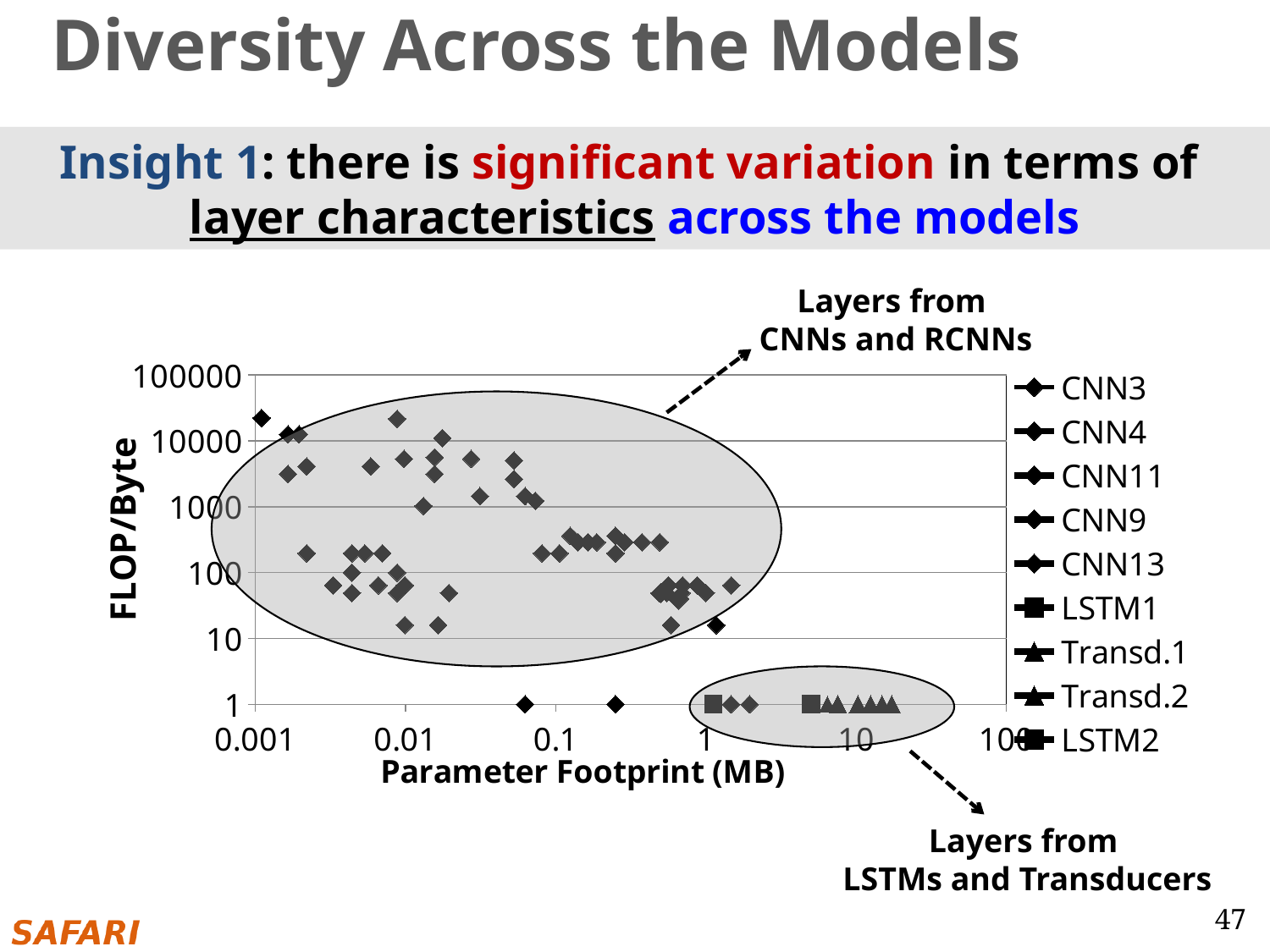
Is the parameter footprint of the layers from LSTMs and Transducers greater or less than 0.1 MB? greater What kind of chart is shown on the slide? Scatter plot What is the label of the y-axis of the chart? FLOP/Byte According to the annotation, which models do the layers in the large upper ellipse come from? CNNs and RCNNs Which group of layers has higher FLOP/Byte values: the layers from CNNs and RCNNs or the layers from LSTMs and Transducers? Layers from CNNs and RCNNs What is the label of the x-axis of the chart? Parameter Footprint (MB) Are the FLOP/Byte values of the layers from LSTMs and Transducers greater or less than 10? less How many series does the legend of the chart list? 9 According to the annotation, which models do the layers in the lower-right ellipse come from? LSTMs and Transducers What is the lowest value shown on the x-axis of the chart? 0.001 What is the highest value shown on the y-axis of the chart? 100000 How many CNN series are listed in the legend? 5